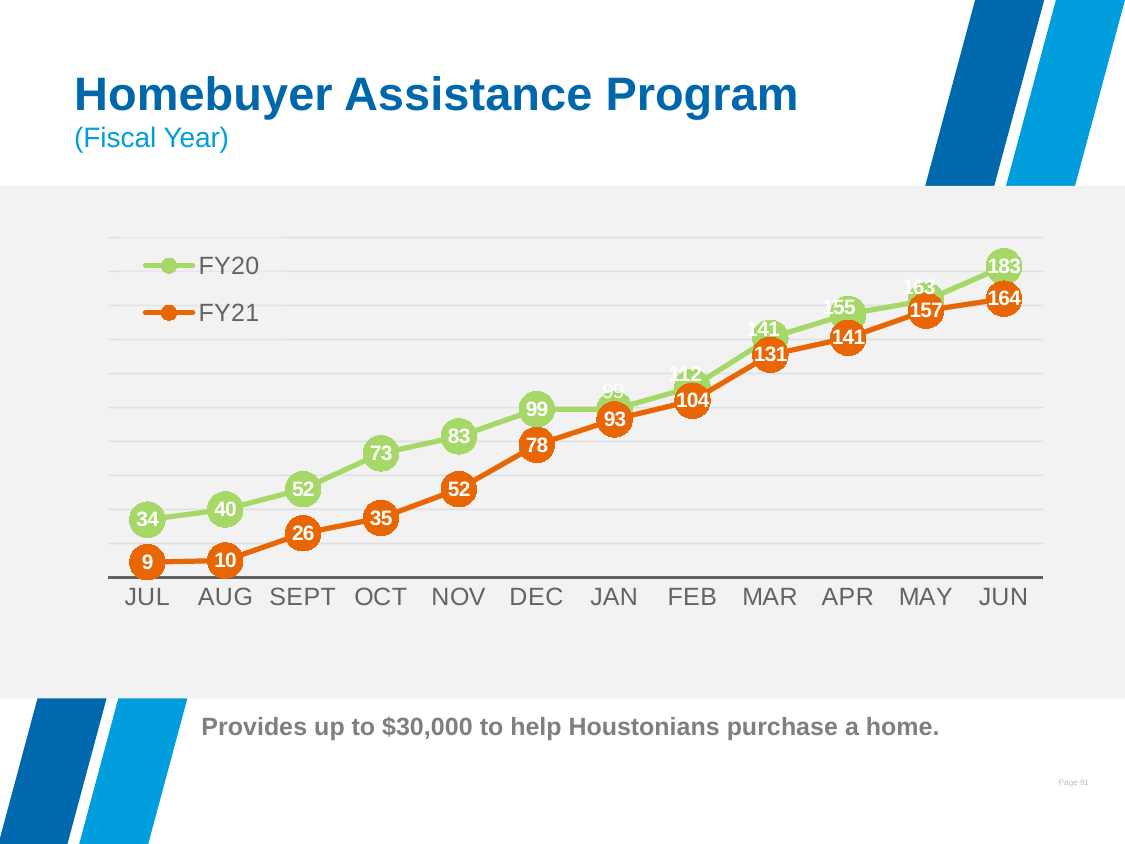
Do the FY21 values rise or fall from JUL to JUN? rise What is the FY21 value for DEC? 78 How many series does the legend list? 2 What is the FY20 value for JUN? 183 What is the FY21 value for JUL? 9 What is the FY20 value for OCT? 73 Which is larger in NOV, the FY20 value or the FY21 value? FY20 How many months are plotted along the x axis? 12 In which month is the FY20 value lowest? JUL In which month is the FY21 value highest? JUN What is the difference between the FY20 and FY21 values for JUN? 19 What type of chart is shown on the slide? line chart